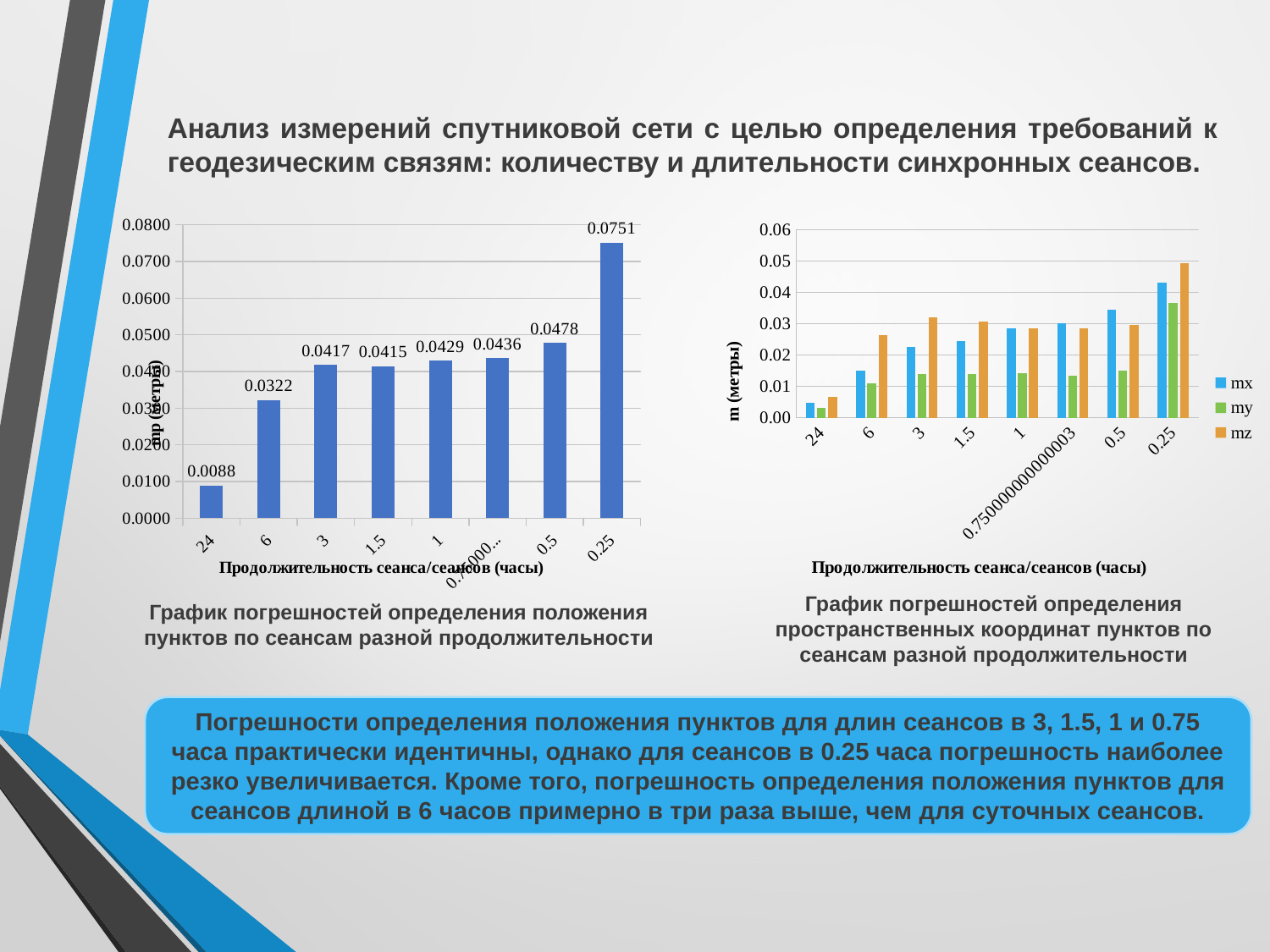
How many bars are plotted on the left chart? 8 On the left chart, which session duration has the highest value? 0.25 On the left chart, what is the value for the 24-hour session? 0.0088 On the left chart, what is the value for the 0.25-hour session? 0.0751 On the right chart, is the my value for the 24-hour session greater or less than 0.01? less On the left chart, what is the value for the 6-hour session? 0.0322 How many series does the legend of the right chart list? 3 On the left chart, what is the difference between the values for the 0.25-hour and 0.5-hour sessions? 0.0273 On the left chart, which is larger: the value for the 3-hour session or the 1.5-hour session? 3-hour session (0.0417) On the right chart, is the mz value for the 0.25-hour session greater or less than 0.04? greater On the left chart, which session duration has the lowest value? 24 What type of chart is the right chart? Bar chart